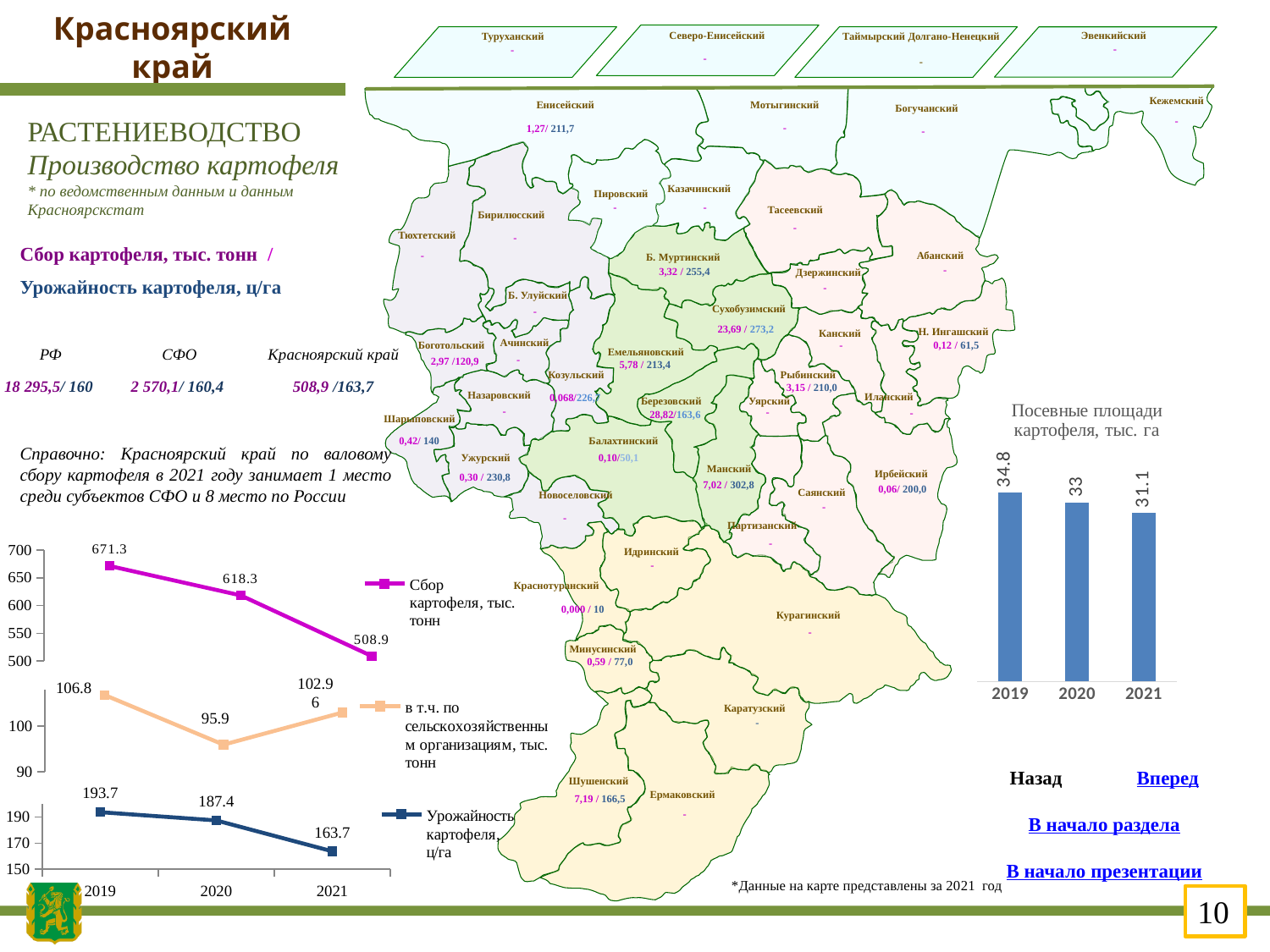
In the line chart at the bottom left, what is the value of 'Сбор картофеля, тыс. тонн' for 2021? 508.9 In the bar chart 'Посевные площади картофеля, тыс. га', what is the value for 2019? 34.8 In the line chart at the bottom left, what is the value of 'Сбор картофеля, тыс. тонн' for 2019? 671.3 What kind of chart is 'Посевные площади картофеля, тыс. га'? bar chart In the bar chart 'Посевные площади картофеля, тыс. га', how many bars are there? 3 In the bar chart 'Посевные площади картофеля, тыс. га', do the values rise or fall from 2019 to 2021? fall In the bar chart 'Посевные площади картофеля, тыс. га', what is the value for 2021? 31.1 In the line chart at the bottom left, what is the difference between the 2019 and 2021 values of 'Урожайность картофеля, ц/га'? 30 In the line chart at the bottom left, what is the value of 'Урожайность картофеля, ц/га' for 2020? 187.4 In the bar chart 'Посевные площади картофеля, тыс. га', which year has the lowest value? 2021 In the line chart at the bottom left, which year has the lowest value of 'в т.ч. по сельскохозяйственным организациям, тыс. тонн'? 2020 In the bar chart 'Посевные площади картофеля, тыс. га', what is the difference between the 2019 and 2021 values? 3.7